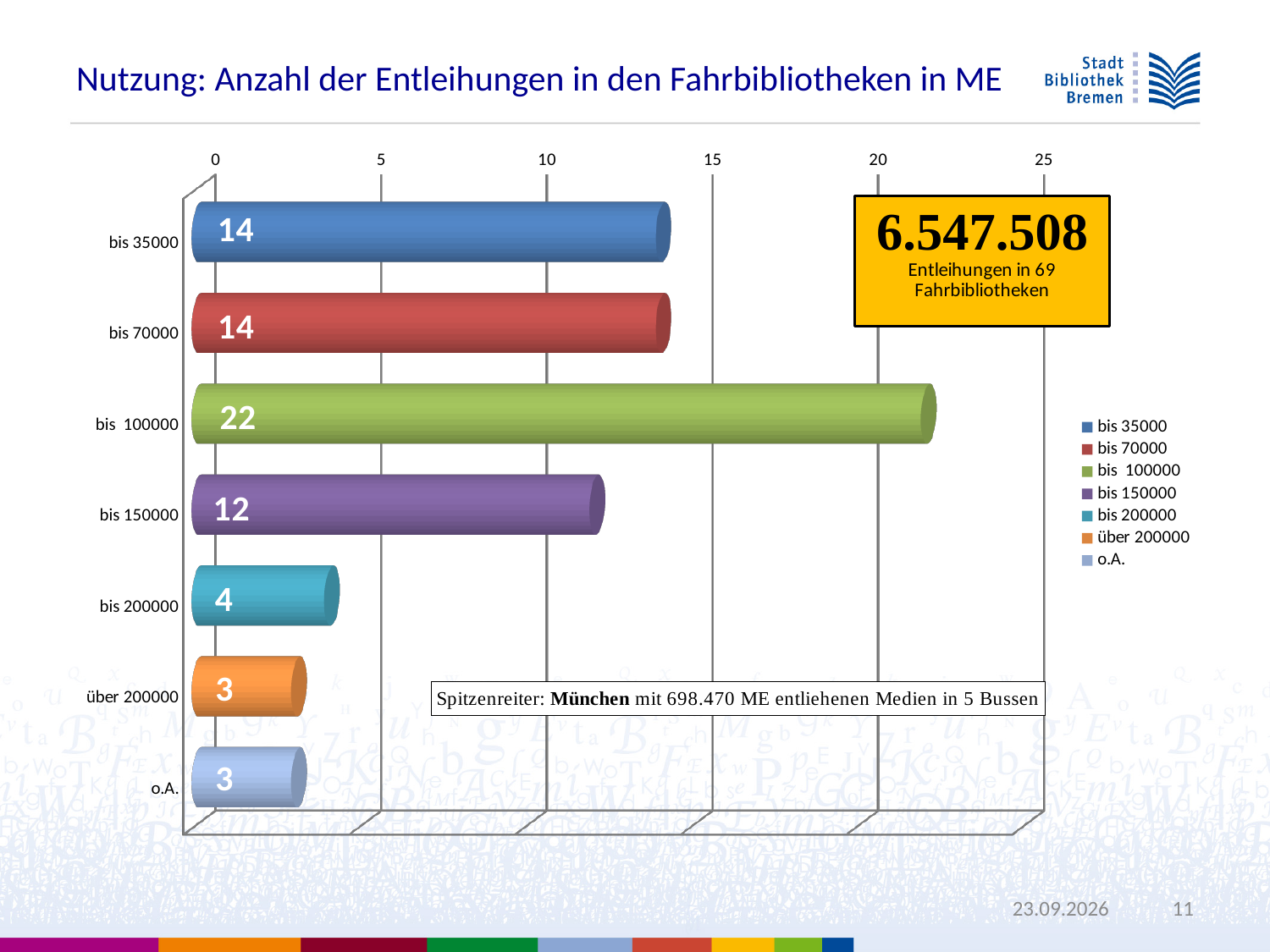
What is the value for the category "über 200000"? 3 What is the value for the category "bis 200000"? 4 What is the total number of Entleihungen shown in the yellow box on the chart? 6.547.508 What is the difference between the values for "bis 100000" and "bis 150000"? 10 What is the value for the category "bis 100000"? 22 How many categories are shown in the chart? 7 What is the value for the category "bis 150000"? 12 Which is larger, the value for "bis 35000" or the value for "bis 200000"? bis 35000 What kind of chart is shown on the slide? bar chart Is the value for "bis 100000" greater or less than 20? greater How many entries does the legend list? 7 Which category has the highest value? bis 100000